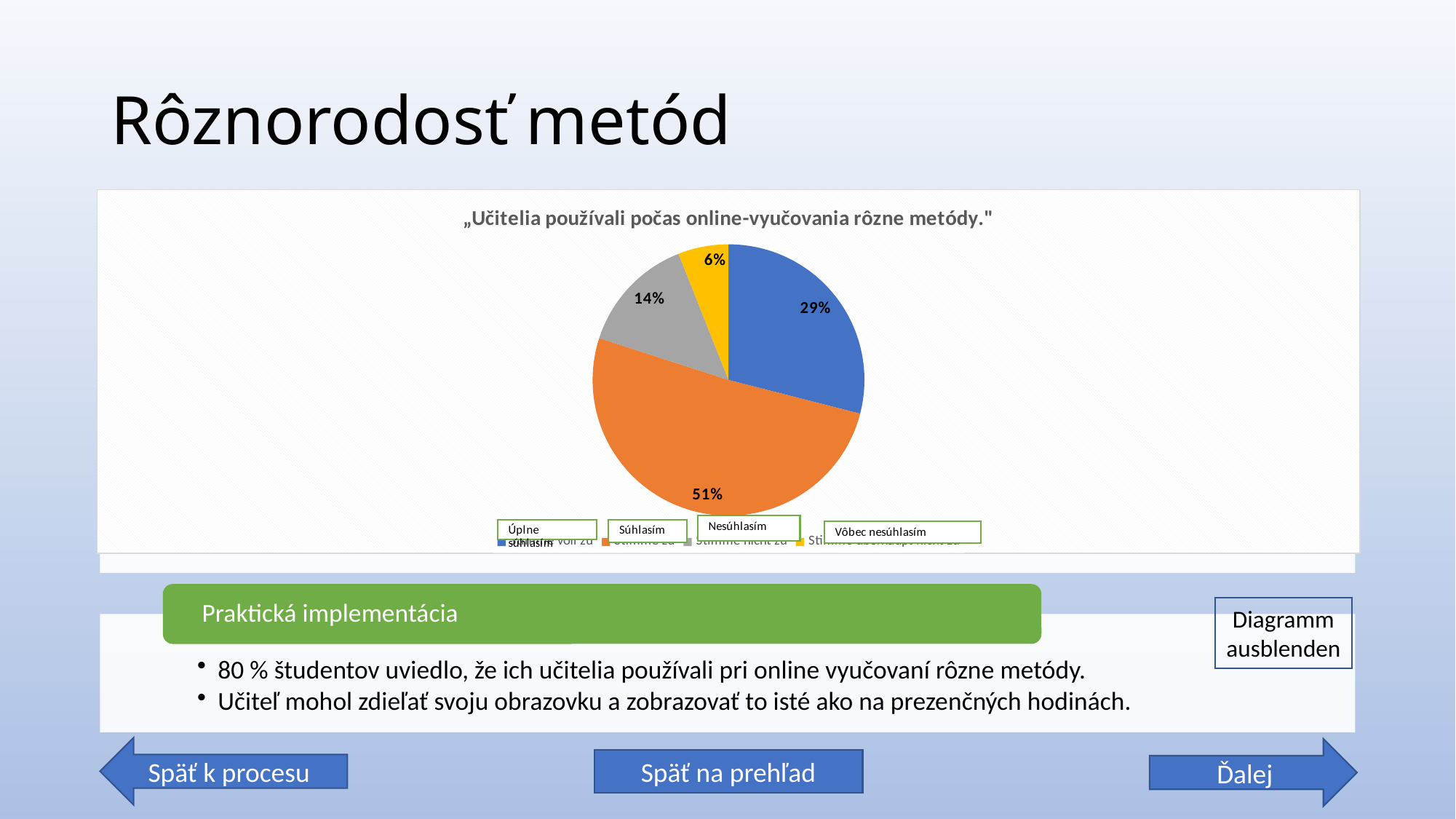
What kind of chart is shown on the slide? pie chart What share of the pie does the "Úplne súhlasím" slice represent? 29% Which category has the largest slice of the pie? Súhlasím What colour is the "Súhlasím" slice of the pie? orange Which category has the smallest slice of the pie? Vôbec nesúhlasím How many slices does the pie chart have? 4 What share of the pie does the "Vôbec nesúhlasím" slice represent? 6% What is the title of the pie chart? „Učitelia používali počas online-vyučovania rôzne metódy." What share of the pie does the "Súhlasím" slice represent? 51% Which slice is larger, "Nesúhlasím" or "Vôbec nesúhlasím"? Nesúhlasím What is the difference in percentage points between the "Súhlasím" and "Úplne súhlasím" slices? 22